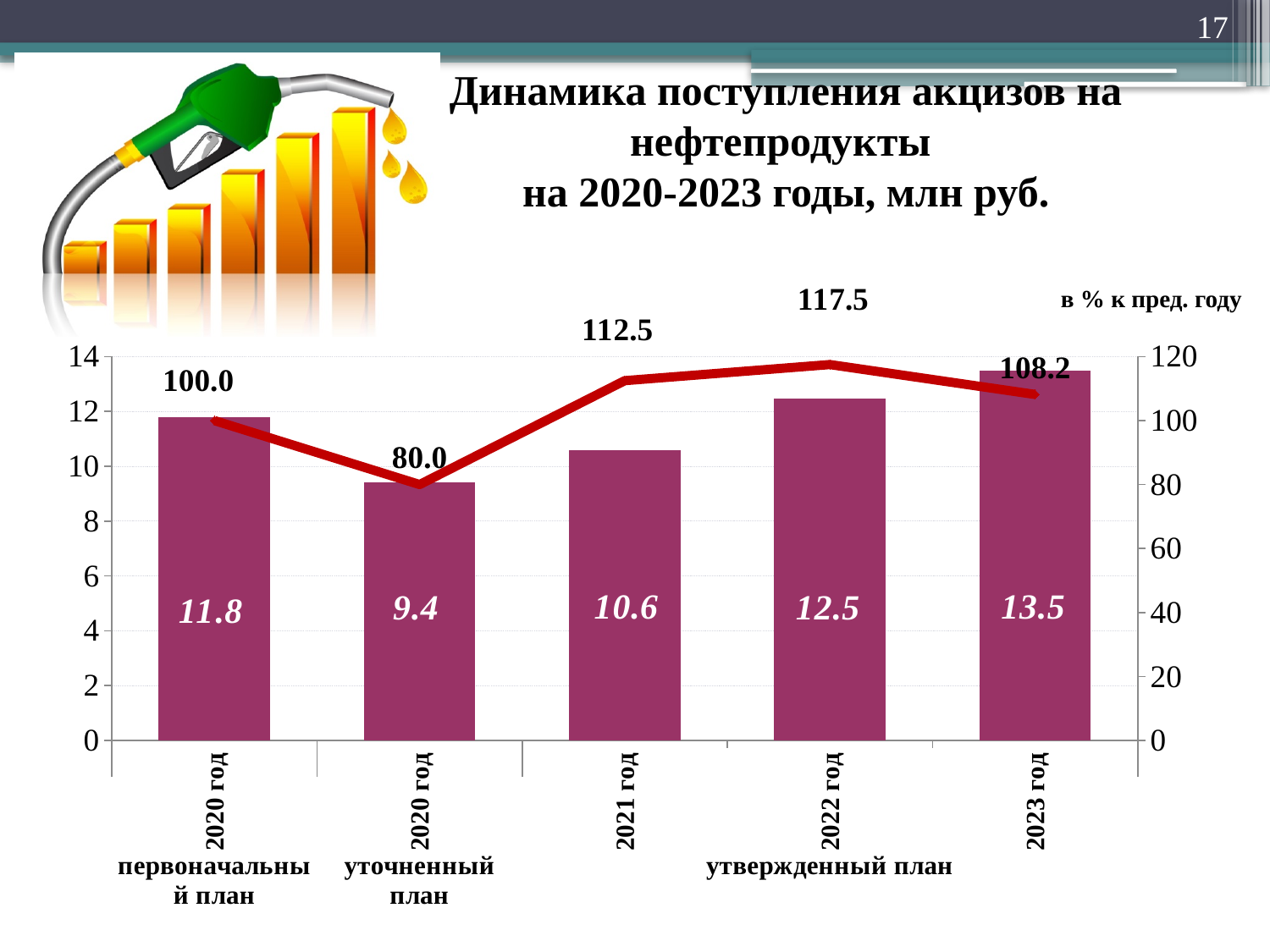
Do the bar values rise or fall from 2021 год to 2023 год? rise What is the line value (в % к пред. году) for 2021 год? 112.5 What is the line value (в % к пред. году) for 2022 год? 117.5 Which category has the lowest bar value? 2020 год (уточненный план) What is the bar value for 2020 год (уточненный план)? 9.4 How many bars are plotted in the chart? 5 Which category has the highest bar value? 2023 год What is the lowest line value (в % к пред. году) shown on the chart? 80.0 Which is larger, the bar value for 2021 год or for 2022 год? 2022 год What is the bar value for 2023 год? 13.5 What is the difference between the bar values for 2020 год (первоначальный план) and 2020 год (уточненный план)? 2.4 What is the difference between the bar values for 2023 год and 2022 год? 1.0